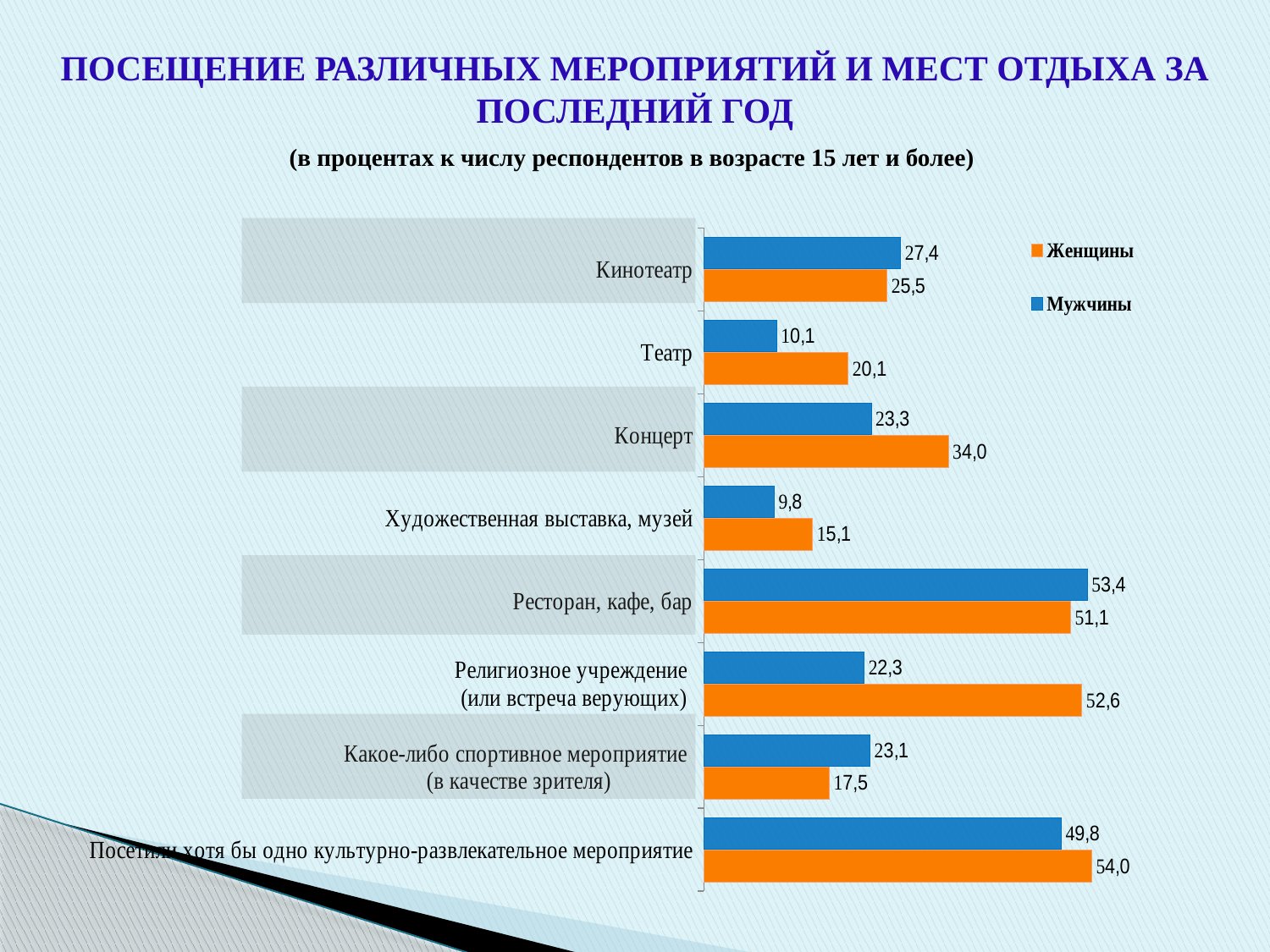
In the Театр category, which series has the larger value, Женщины or Мужчины? Женщины What is the value for Женщины in the Театр category? 20,1 In the Какое-либо спортивное мероприятие (в качестве зрителя) category, which series has the larger value, Женщины or Мужчины? Мужчины How many series does the legend list? 2 Which category has the lowest value for Женщины? Художественная выставка, музей What is the value for Женщины in the Религиозное учреждение (или встреча верующих) category? 52,6 How many categories are shown in the chart? 8 What kind of chart is shown on the slide? Bar chart Which colour represents the Женщины series? Orange What is the difference between the Женщины and Мужчины values in the Концерт category? 10,7 What is the value for Мужчины in the Кинотеатр category? 27,4 Which category has the highest value for Мужчины? Ресторан, кафе, бар